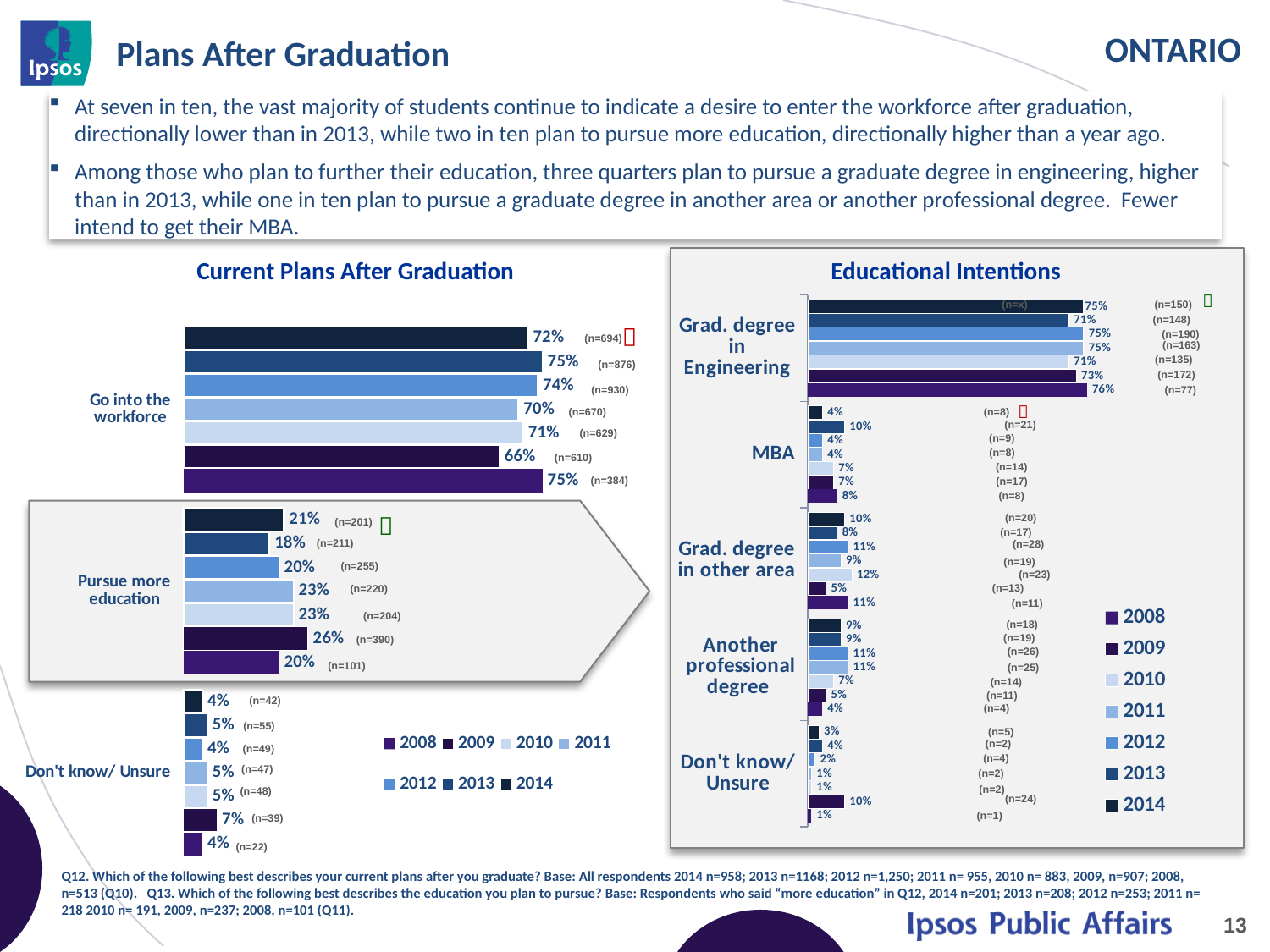
In the Current Plans After Graduation chart, which is larger: the 2011 value or the 2013 value for 'Pursue more education'? 2011 In the Current Plans After Graduation chart, which year has the lowest value for 'Go into the workforce'? 2009 What type of chart is the Educational Intentions chart? Bar chart In the Educational Intentions chart, what is the difference between the 2012 and 2009 values for 'Grad. degree in other area'? 6 percentage points In the Educational Intentions chart, what percentage of 2013 respondents planned to pursue an MBA? 10% How many categories are shown in the Educational Intentions chart? 5 In the Current Plans After Graduation chart, what percentage of 2014 respondents said they would go into the workforce? 72% In the Educational Intentions chart, what percentage of 2008 respondents planned to pursue a graduate degree in engineering? 76% In the Current Plans After Graduation chart, what is the difference between the 2013 and 2014 values for 'Go into the workforce'? 3 percentage points In the Educational Intentions chart, which year has the highest value for 'Don't know/ Unsure'? 2009 How many series does the legend of the Current Plans After Graduation chart list? 7 In the Current Plans After Graduation chart, what percentage of 2009 respondents planned to pursue more education? 26%